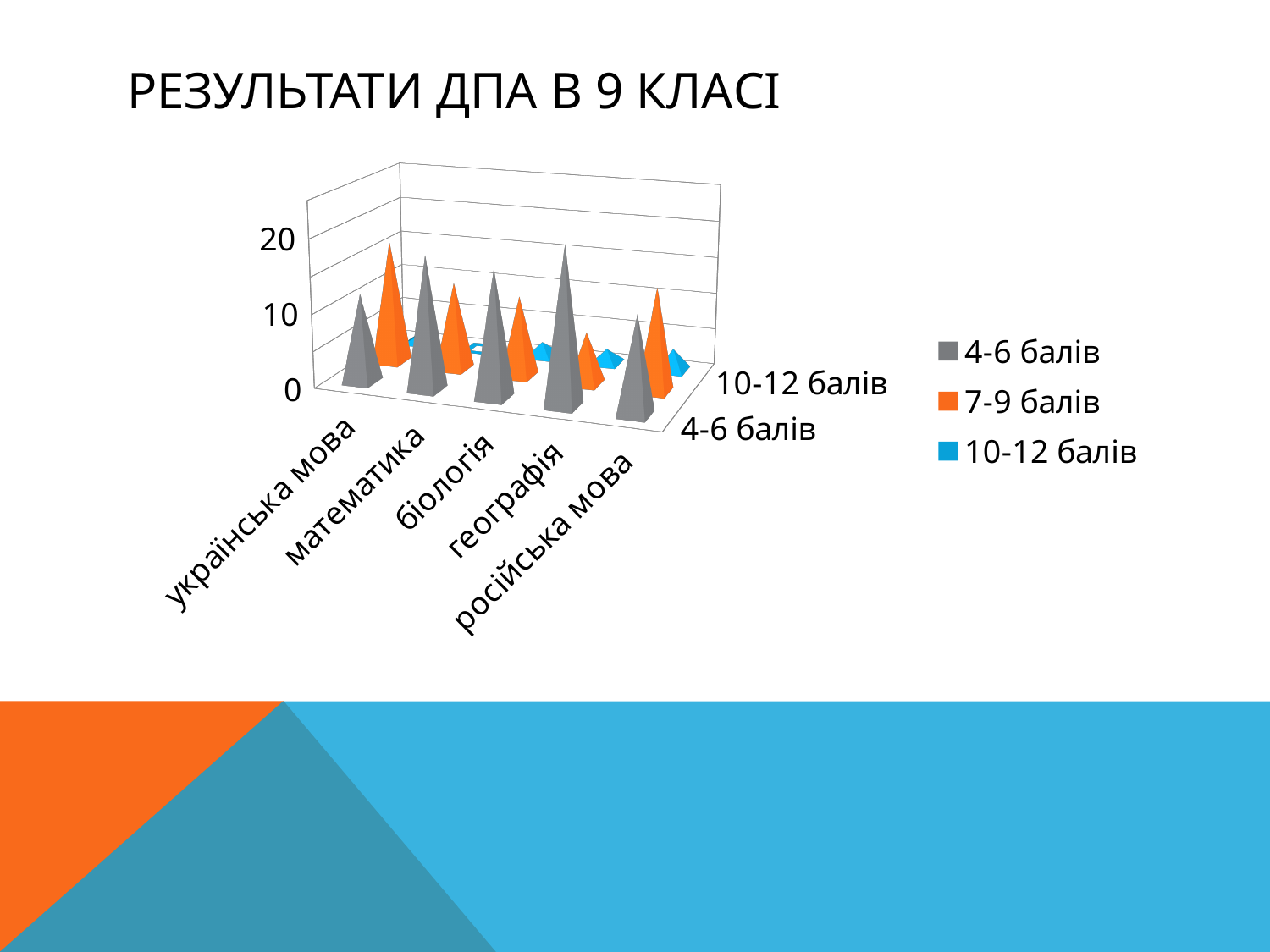
What is the title of the chart? РЕЗУЛЬТАТИ ДПА В 9 КЛАСІ Is the value for 10-12 балів for українська мова greater or less than 10? less Which is larger for 7-9 балів: українська мова or географія? українська мова Which subject has the highest value for 7-9 балів? українська мова What kind of chart is shown on the slide? bar chart Which is larger for 4-6 балів: географія or російська мова? географія Which subject has the highest value for 4-6 балів? географія How many series does the legend list? 3 Which colour represents the 7-9 балів series? orange How many subjects (categories) are shown on the chart? 5 Which subject has the lowest value for 7-9 балів? географія Is the value for 4-6 балів for географія greater or less than 10? greater